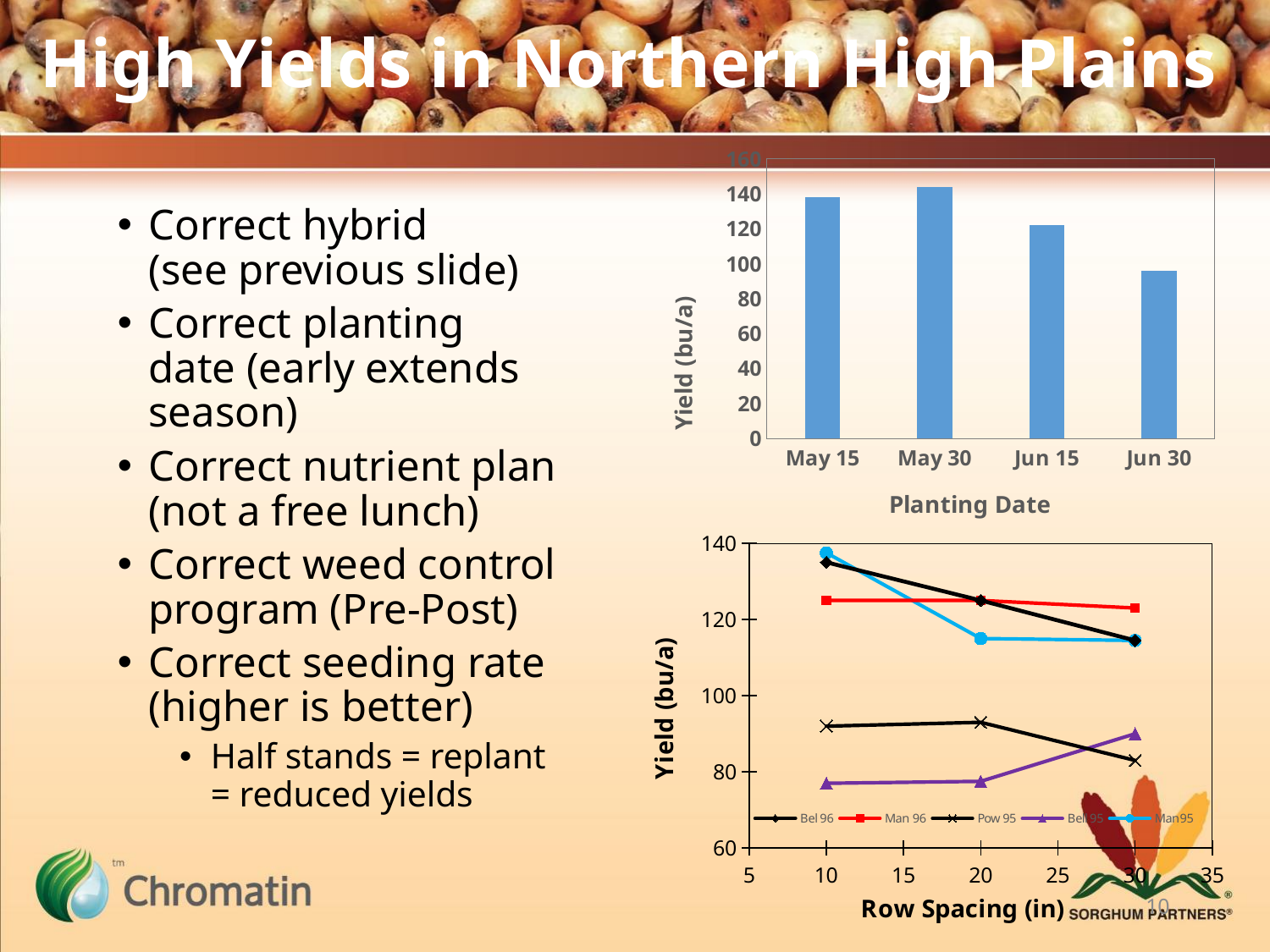
In the bottom chart (Row Spacing), how many series does the legend list? 5 In the top chart (Planting Date), is the yield for Jun 30 greater or less than 100? less In the top chart (Planting Date), how many planting dates are shown? 4 What kind of chart is the bottom chart (Row Spacing)? line chart In the bottom chart (Row Spacing), does the yield for Bel 96 rise or fall as row spacing increases? fall In the top chart (Planting Date), which planting date has the highest yield? May 30 What kind of chart is the top chart (Planting Date)? bar chart In the top chart (Planting Date), does the yield rise or fall from May 30 to Jun 30? fall In the bottom chart (Row Spacing), is the yield for Bel 95 at 10 in greater or less than 80? less In the top chart (Planting Date), which planting date has the lowest yield? Jun 30 In the top chart (Planting Date), is the yield for May 15 greater or less than 120? greater In the bottom chart (Row Spacing), which series has the highest yield at 30 in row spacing? Man 96